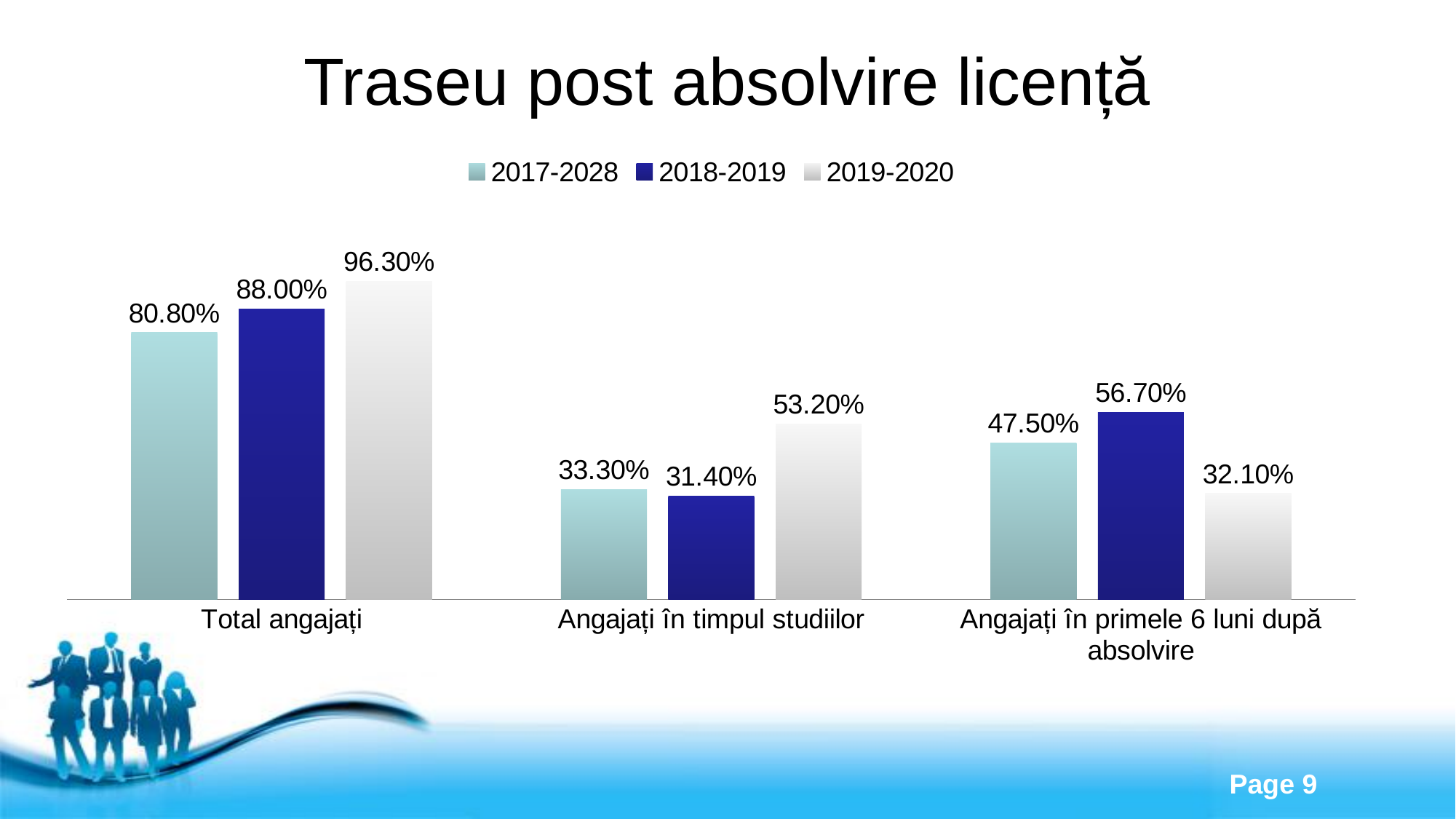
Do the values for the 2019-2020 series rise or fall from Angajați în timpul studiilor to Angajați în primele 6 luni după absolvire? Fall How many series does the legend list? 3 What is the value for 2019-2020 in the Total angajați category? 96.30% Which is larger: the 2019-2020 value for Angajați în timpul studiilor or the 2019-2020 value for Angajați în primele 6 luni după absolvire? Angajați în timpul studiilor Which series has the highest value in the Angajați în primele 6 luni după absolvire category? 2018-2019 What is the title of the slide? Traseu post absolvire licență What is the value for 2018-2019 in the Angajați în timpul studiilor category? 31.40% What is the value for 2017-2028 in the Angajați în primele 6 luni după absolvire category? 47.50% How many categories are shown on the x axis? 3 Which series has the lowest value in the Angajați în timpul studiilor category? 2018-2019 What is the difference between the 2019-2020 and 2017-2028 values for Total angajați? 15.50% What kind of chart is shown on the slide? Bar chart